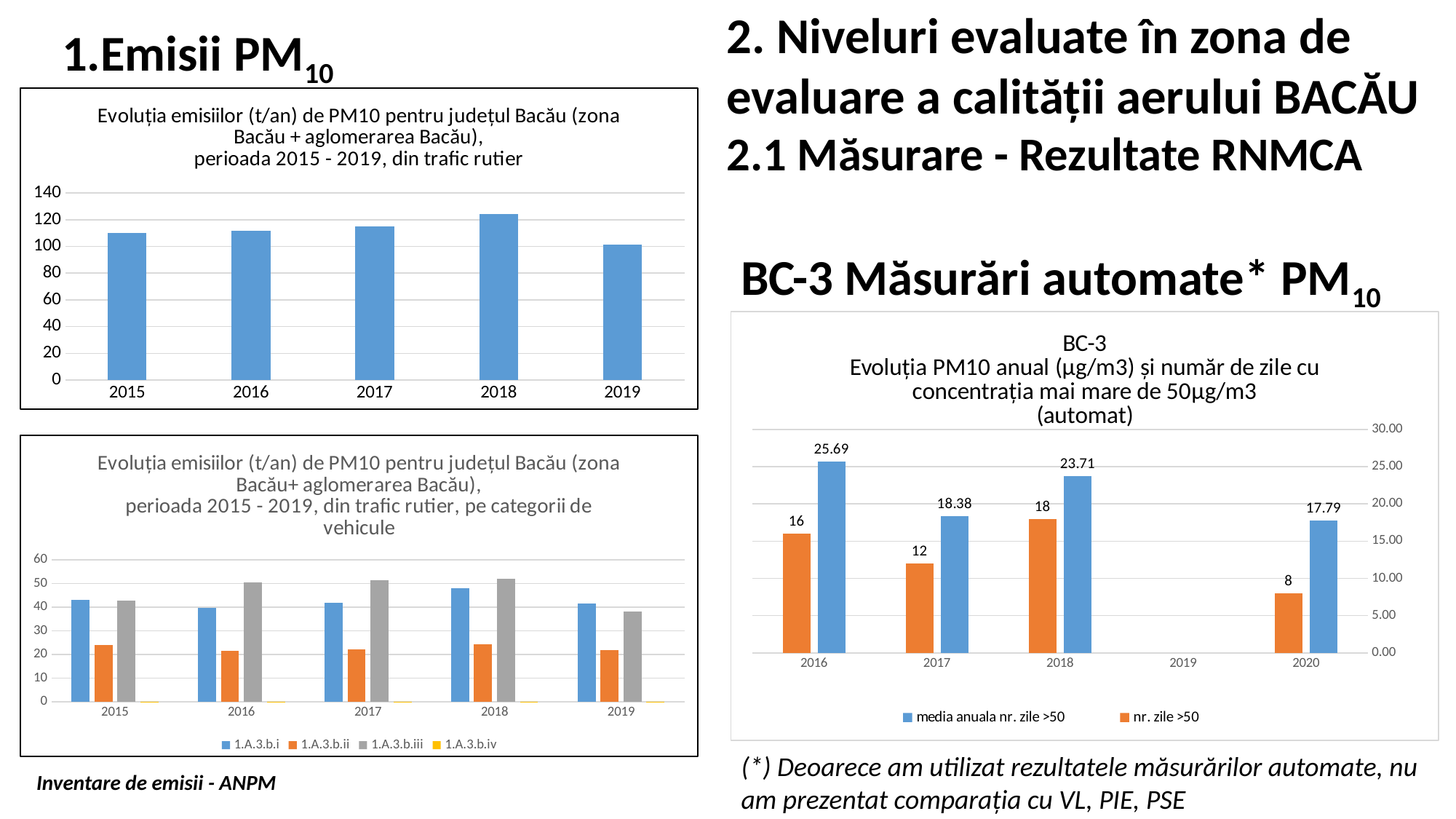
How many years are shown on the x axis of the top-left chart (Evoluția emisiilor de PM10 din trafic rutier)? 5 In the BC-3 chart on the right, what is the nr. zile >50 value for 2018? 18 In the BC-3 chart on the right, what is the difference between the media anuala values for 2016 and 2020? 7.90 In the top-left chart (Evoluția emisiilor de PM10 din trafic rutier), which year has the highest emissions? 2018 In the top-left chart (Evoluția emisiilor de PM10 din trafic rutier), which year has the lowest emissions? 2019 In the top-left chart (Evoluția emisiilor de PM10 din trafic rutier), is the value for 2018 greater or less than 120? greater How many series does the legend of the bottom-left chart (emisii PM10 pe categorii de vehicule) list? 4 In the BC-3 chart on the right, which year has the lowest nr. zile >50 value among the years with bars? 2020 In the BC-3 chart on the right, what is the media anuala value for 2016? 25.69 In the bottom-left chart (emisii PM10 pe categorii de vehicule), which series has the highest value in 2018? 1.A.3.b.iii What type of chart is the bottom-left chart (emisii PM10 pe categorii de vehicule)? bar chart In the top-left chart (Evoluția emisiilor de PM10 din trafic rutier), is the value for 2019 greater or less than 120? less